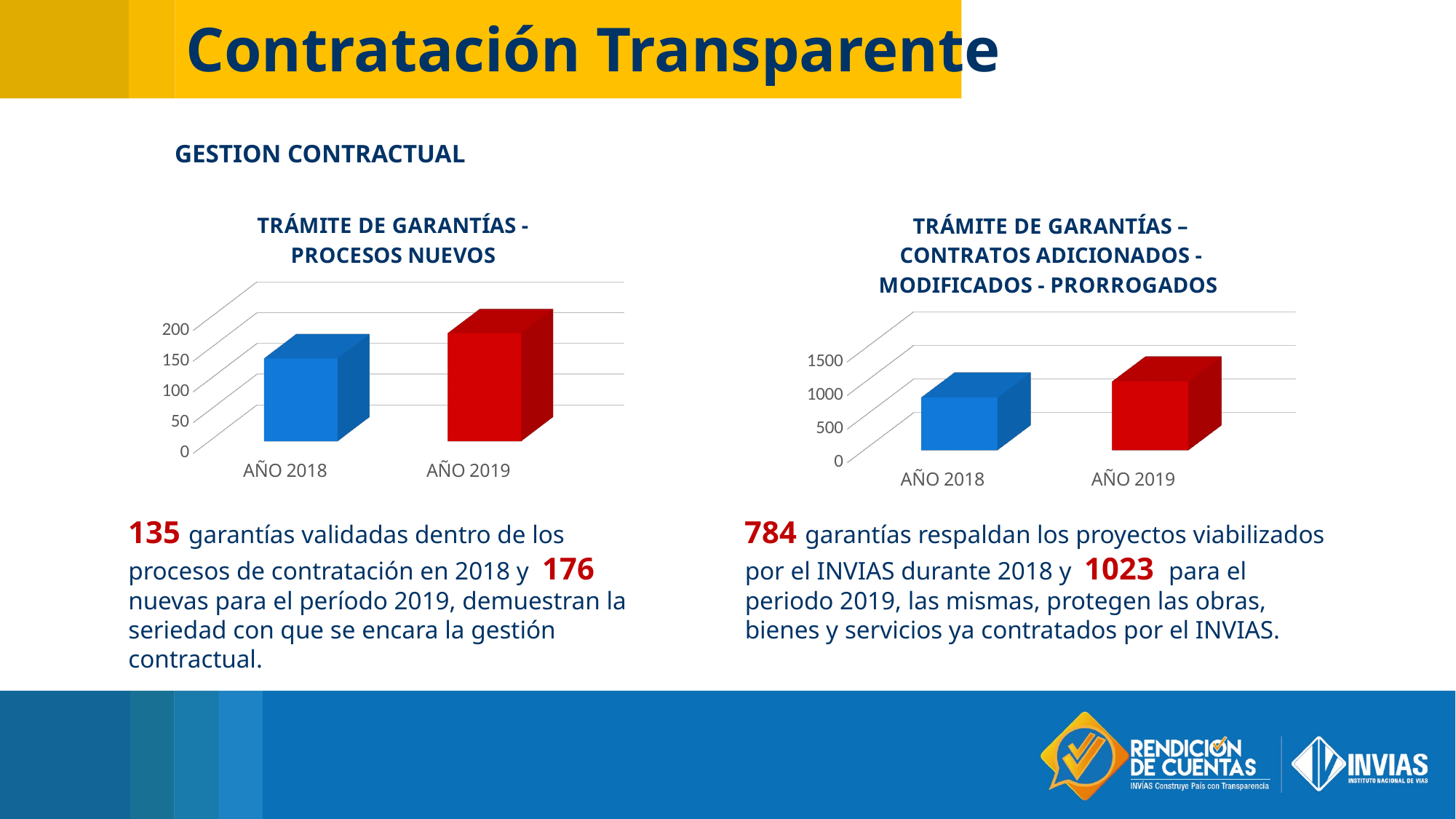
What kind of chart is the one titled 'TRÁMITE DE GARANTÍAS - PROCESOS NUEVOS'? bar chart In the chart titled 'TRÁMITE DE GARANTÍAS - PROCESOS NUEVOS', how many categories are shown on the x axis? 2 In the chart titled 'TRÁMITE DE GARANTÍAS – CONTRATOS ADICIONADOS - MODIFICADOS - PRORROGADOS', what is the highest value labelled on the vertical axis? 1500 In the chart titled 'TRÁMITE DE GARANTÍAS – CONTRATOS ADICIONADOS - MODIFICADOS - PRORROGADOS', do the values rise or fall from AÑO 2018 to AÑO 2019? rise In the chart titled 'TRÁMITE DE GARANTÍAS - PROCESOS NUEVOS', is the value for AÑO 2018 greater or less than 100? greater In the chart titled 'TRÁMITE DE GARANTÍAS – CONTRATOS ADICIONADOS - MODIFICADOS - PRORROGADOS', is the value for AÑO 2018 greater or less than 500? greater In the chart titled 'TRÁMITE DE GARANTÍAS - PROCESOS NUEVOS', is the value for AÑO 2019 greater or less than 150? greater In the chart titled 'TRÁMITE DE GARANTÍAS - PROCESOS NUEVOS', what colour is the bar for AÑO 2019? red In the chart titled 'TRÁMITE DE GARANTÍAS – CONTRATOS ADICIONADOS - MODIFICADOS - PRORROGADOS', which year has the higher bar? AÑO 2019 In the chart titled 'TRÁMITE DE GARANTÍAS - PROCESOS NUEVOS', which year has the lower bar? AÑO 2018 In the chart titled 'TRÁMITE DE GARANTÍAS - PROCESOS NUEVOS', which year has the higher bar? AÑO 2019